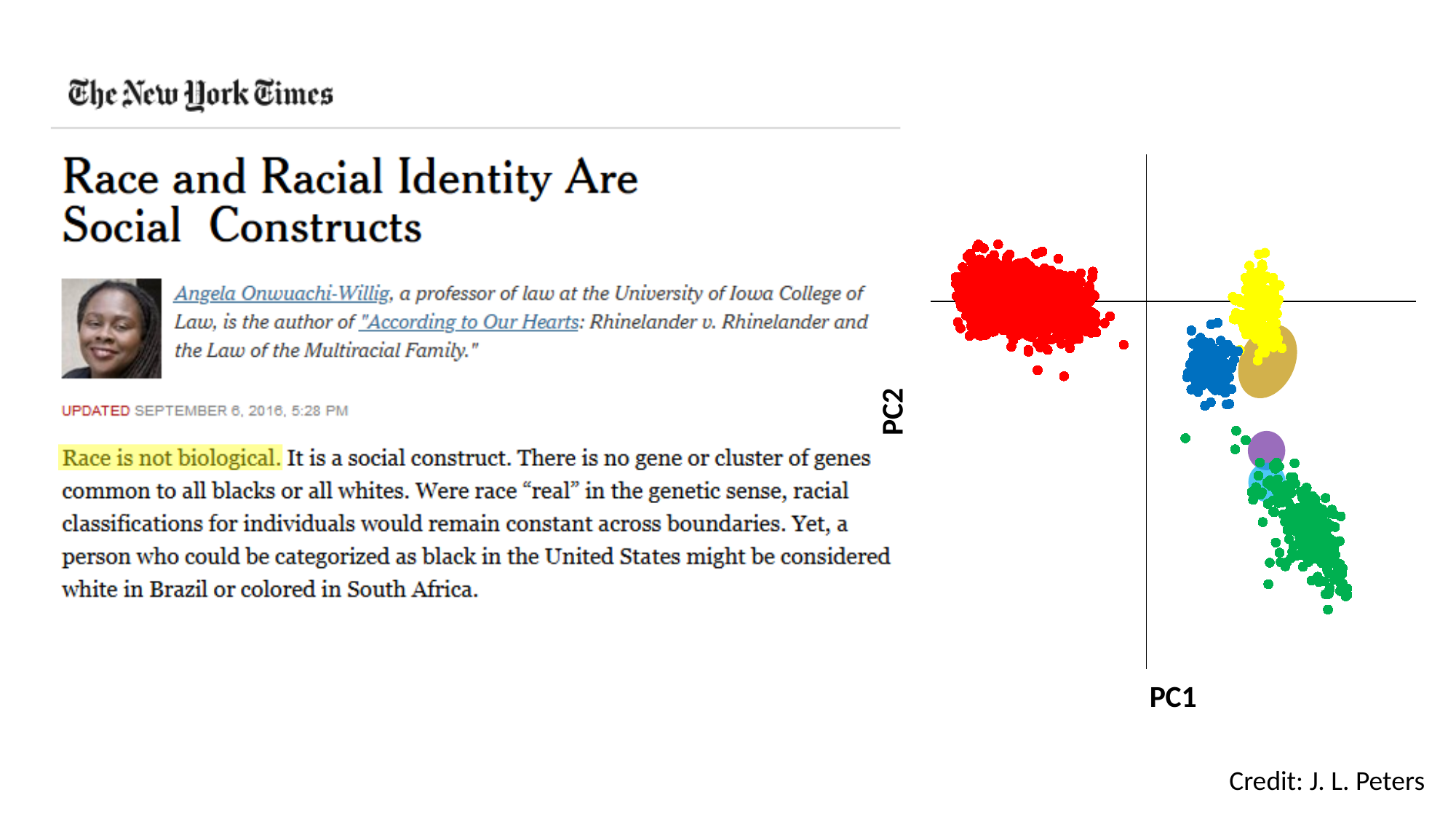
Which colour cluster lies farthest to the right along PC1 in the scatter plot? green Which colour cluster lies lowest along PC2 in the scatter plot? green What are the labels of the horizontal and vertical axes of the scatter plot? PC1 and PC2 In the scatter plot, is the red cluster to the left or to the right of the green cluster along PC1? left What kind of chart is shown on the right side of the slide? scatter plot Who is credited for the scatter plot on the slide? J. L. Peters In the scatter plot, is the yellow cluster higher or lower than the green cluster along PC2? higher In the scatter plot, is the blue cluster to the left or to the right of the yellow cluster along PC1? left Which colour cluster lies farthest to the left along PC1 in the scatter plot? red